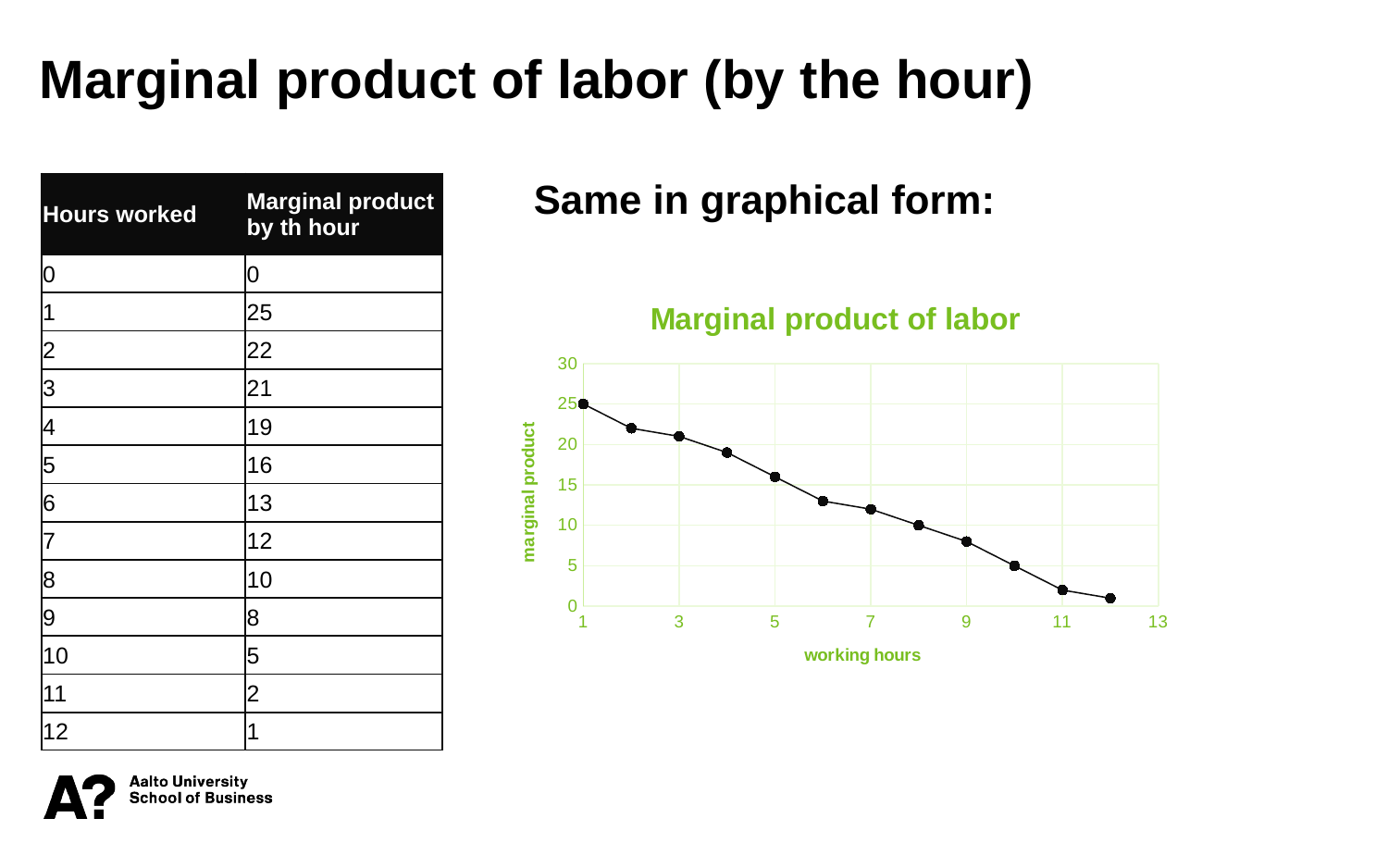
What is the label of the x axis of the chart? working hours What is the marginal product at working hour 8 on the chart? 10 Is the marginal product at working hour 4 greater or less than 15? greater At which working hour is the marginal product lowest on the chart? 12 What is the marginal product at working hour 1 on the chart? 25 Which is larger on the chart, the marginal product at working hour 3 or at working hour 9? working hour 3 What is the title of the chart? Marginal product of labor What kind of chart is shown on the slide? line chart How many data points are plotted on the chart? 12 At which working hour is the marginal product highest on the chart? 1 What is the marginal product at working hour 10 on the chart? 5 Do the values on the chart rise or fall as working hours increase? fall